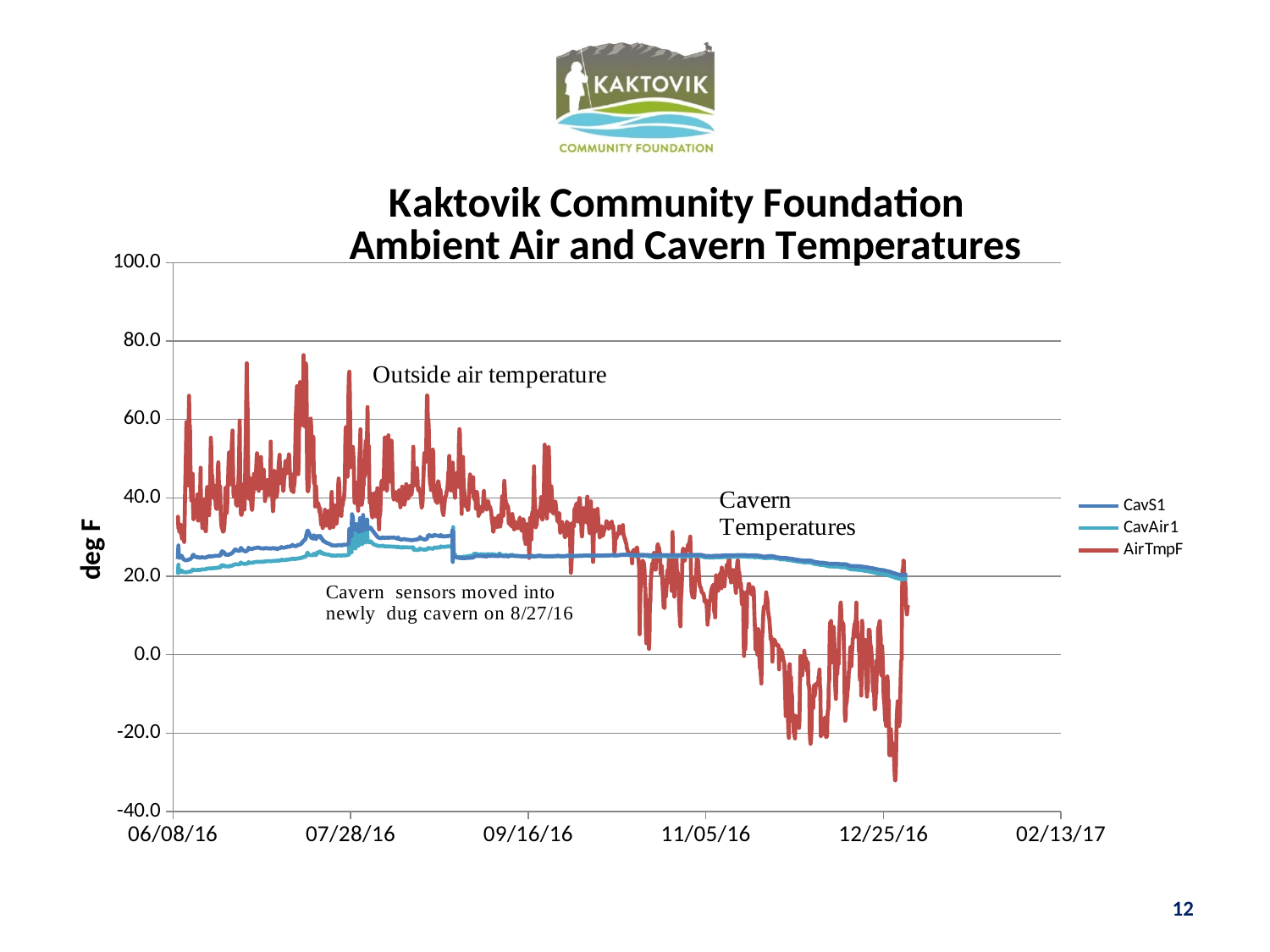
What are the three series named in the legend? CavS1, CavAir1, AirTmpF What is the label on the vertical axis? deg F Which series reaches the lowest value on the chart? AirTmpF Is the AirTmpF value around 12/25/16 greater or less than 0.0? less Around 12/25/16, which series has the higher value, CavS1 or AirTmpF? CavS1 Is the peak of the AirTmpF series in July 2016 greater or less than 60.0? greater Which series reaches the highest value on the chart? AirTmpF Is the CavAir1 value around 11/05/16 greater or less than 40.0? less Does the AirTmpF (outside air temperature) series generally rise or fall from June 2016 to December 2016? fall What kind of chart is shown on the slide? line chart How many series does the legend list? 3